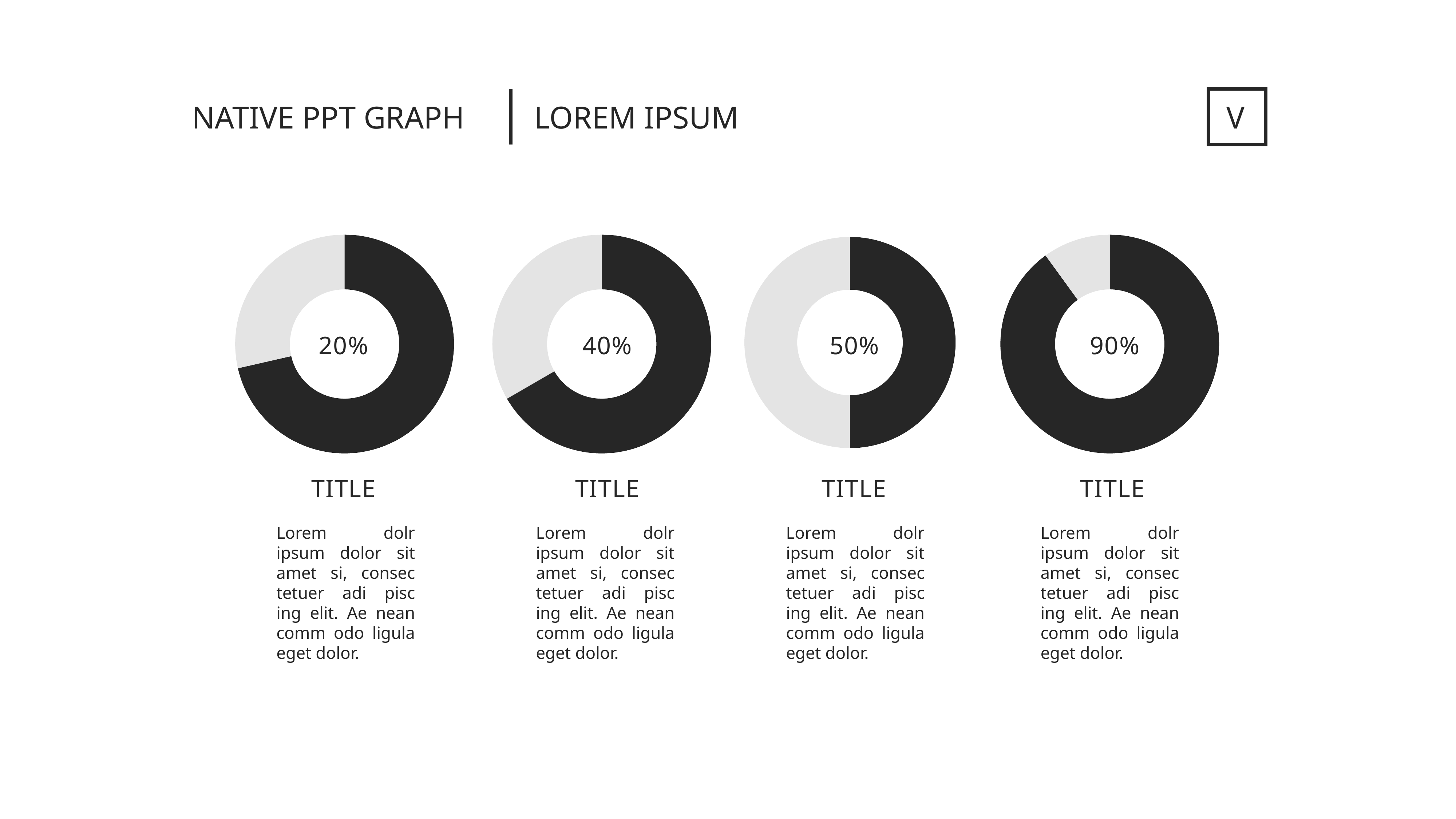
Which donut chart shows the highest percentage? The rightmost chart (90%) Which donut chart shows the lowest percentage? The leftmost chart (20%) What percentage is shown in the centre of the third donut chart from the left? 50% What is the heading text at the top left of the slide? NATIVE PPT GRAPH What percentage is shown in the centre of the leftmost donut chart? 20% Which shows a larger percentage, the second donut chart from the left or the rightmost donut chart? The rightmost donut chart What is the difference between the percentage in the rightmost donut chart and the percentage in the leftmost donut chart? 70 percentage points What percentage is shown in the centre of the second donut chart from the left? 40% How many donut charts are on the slide? 4 What percentage is shown in the centre of the rightmost donut chart? 90% What is the difference between the percentages shown in the second and third donut charts from the left? 10 percentage points What kind of chart is used on this slide? Donut (pie) chart